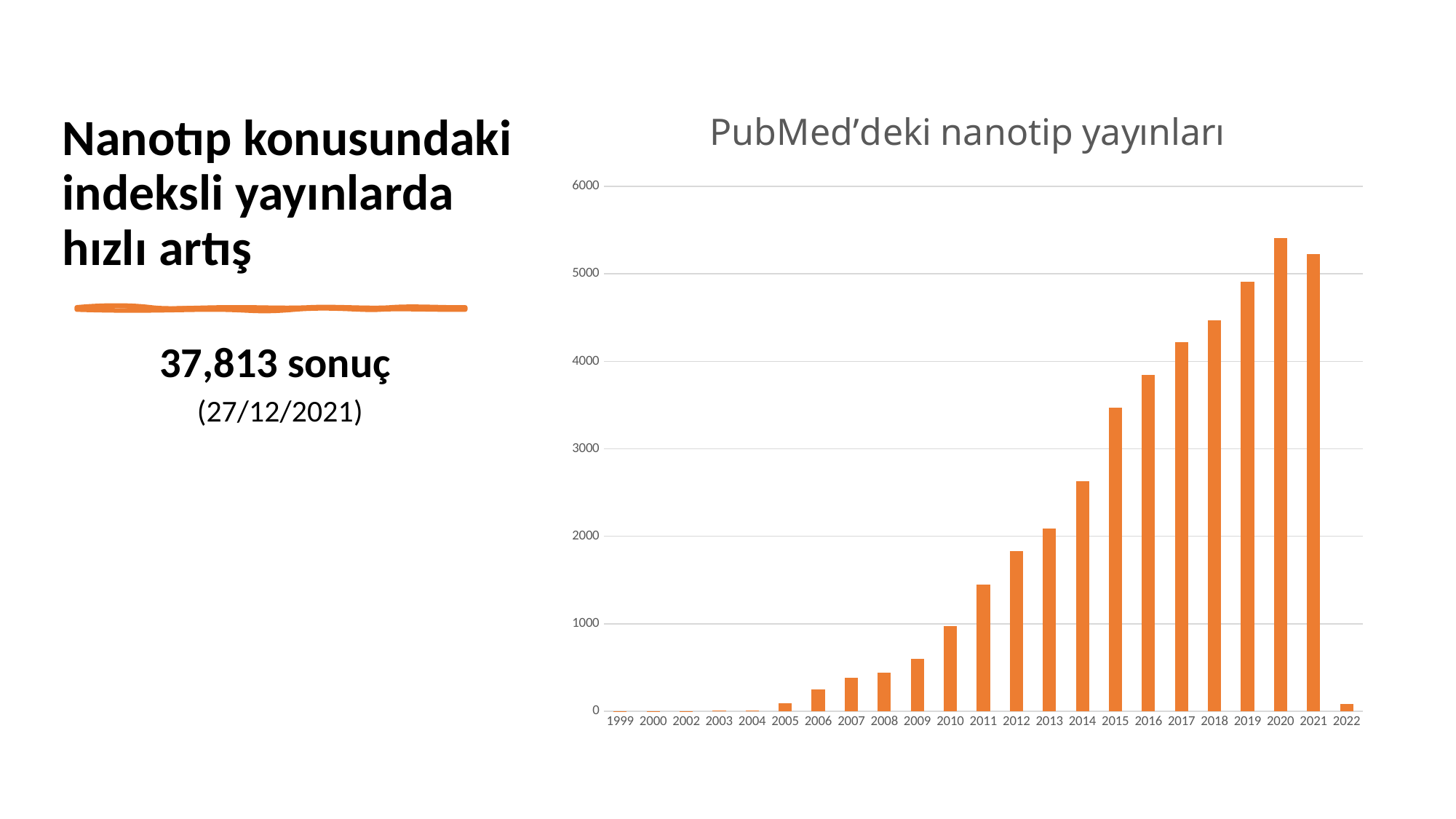
Is the value for 2012 greater or less than 2000? less Which year has the larger value, 2020 or 2021? 2020 Is the value for 2015 greater or less than 3000? greater Is the value for 2014 greater or less than 3000? less How many years are shown on the x axis of the chart? 23 Do the values generally rise or fall from 1999 to 2020? rise What is the title of the chart? PubMed'deki nanotip yayınları Which year has the highest bar in the chart? 2020 What kind of chart is shown on the slide? bar chart